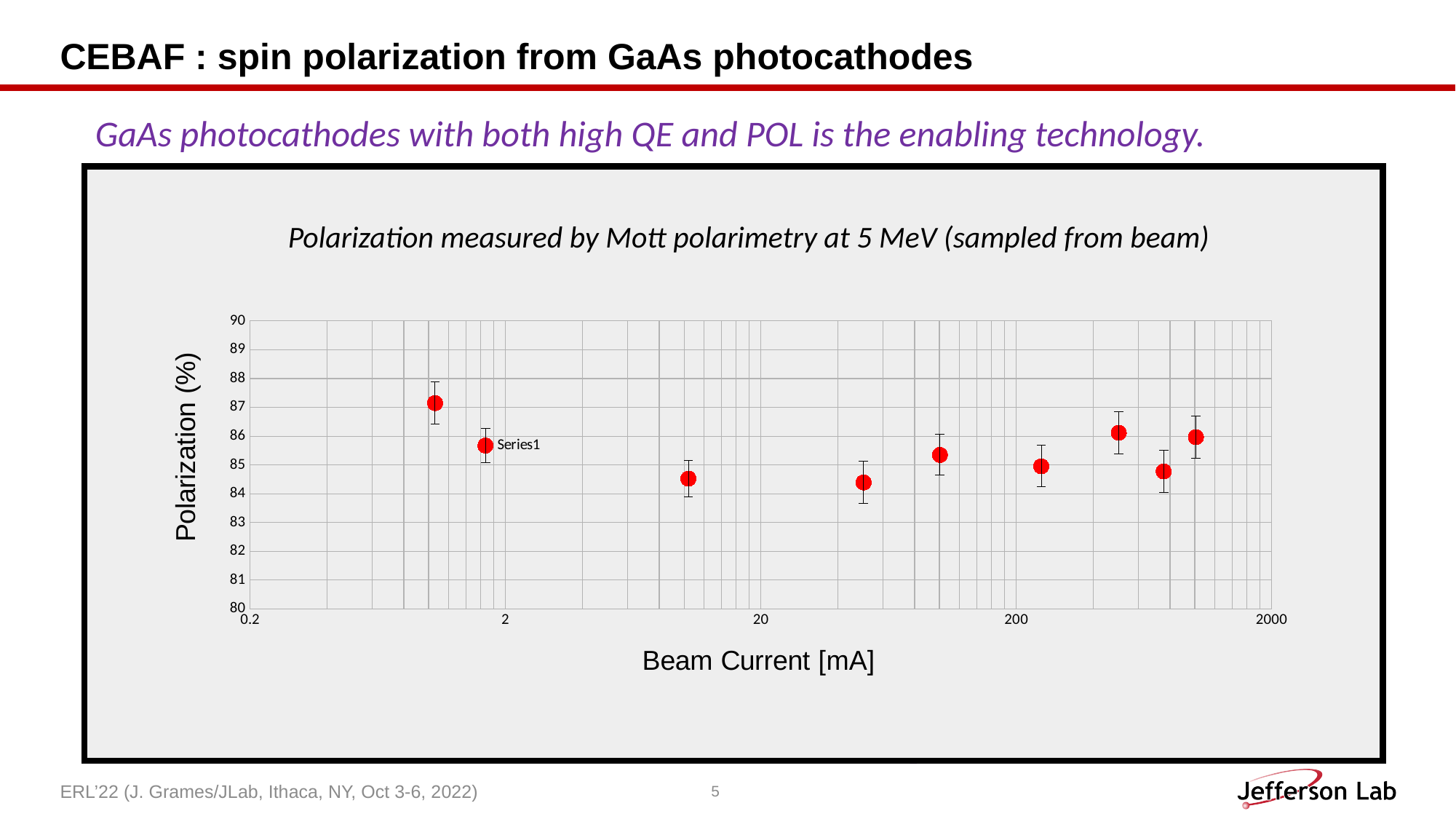
Is the polarization value of the data point just below 20 mA greater or less than 85? less Are all plotted polarization values greater or less than 88? less Which data point has the highest polarization: the leftmost point or the rightmost point? the leftmost point What kind of chart is shown on the slide? scatter chart Is the polarization value of the rightmost data point greater or less than 85? greater What is the lowest value shown on the y axis of the chart? 80 How many data points are plotted in the chart? 9 How many series are plotted in the chart? 1 What is the title of the chart? Polarization measured by Mott polarimetry at 5 MeV (sampled from beam) What is the label of the x axis of the chart? Beam Current [mA]